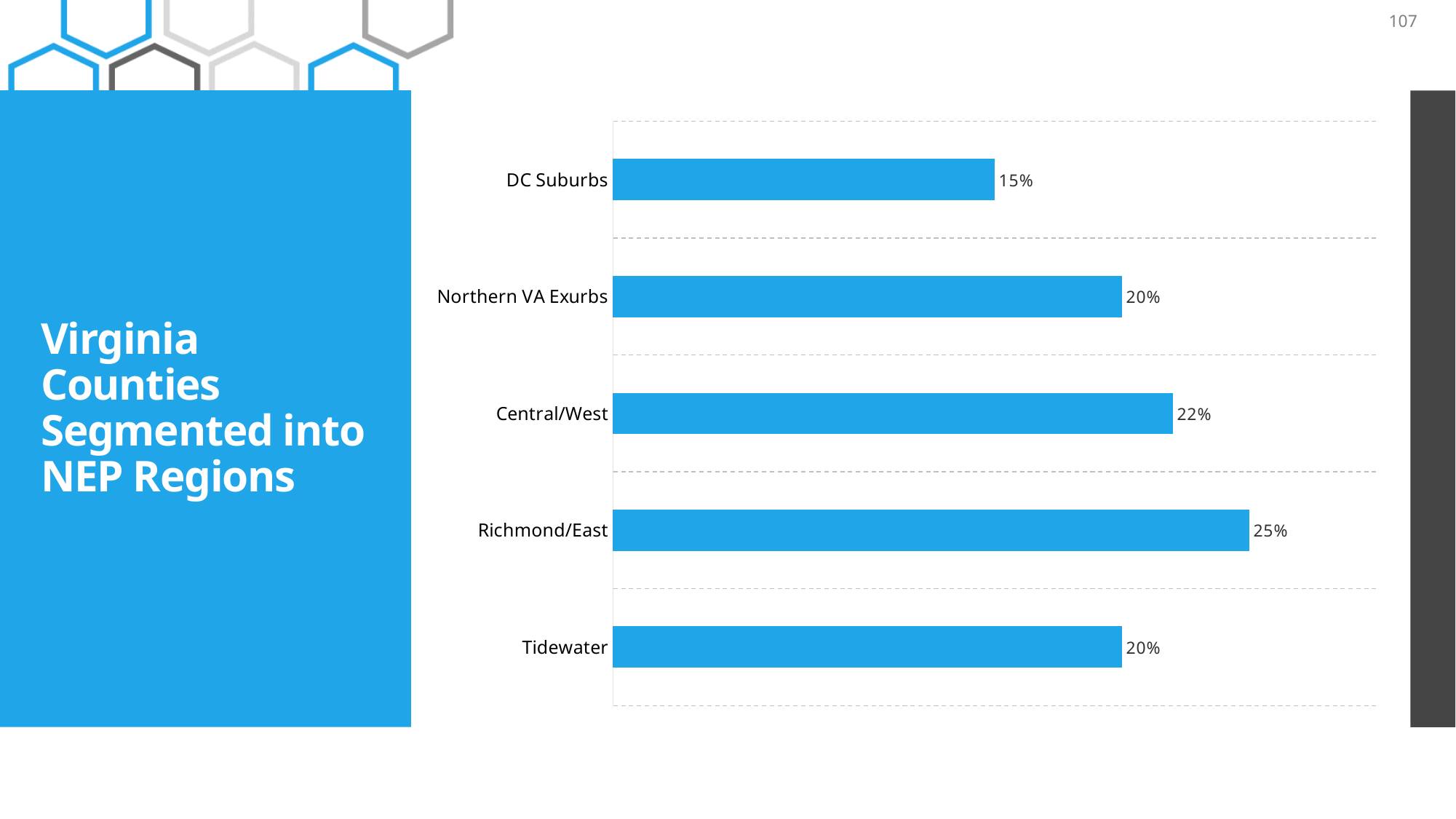
What is the value for Central/West? 22% Which is larger, the value for Central/West or the value for Tidewater? Central/West How many regions are shown in the chart? 5 Which region has the highest value? Richmond/East Which region has the lowest value? DC Suburbs What is the difference between the values for Central/West and Northern VA Exurbs? 2% What kind of chart is shown on the slide? Bar chart What is the difference between the values for Richmond/East and DC Suburbs? 10% What is the value for Tidewater? 20% What is the value for DC Suburbs? 15% What is the value for Richmond/East? 25% What is the value for Northern VA Exurbs? 20%